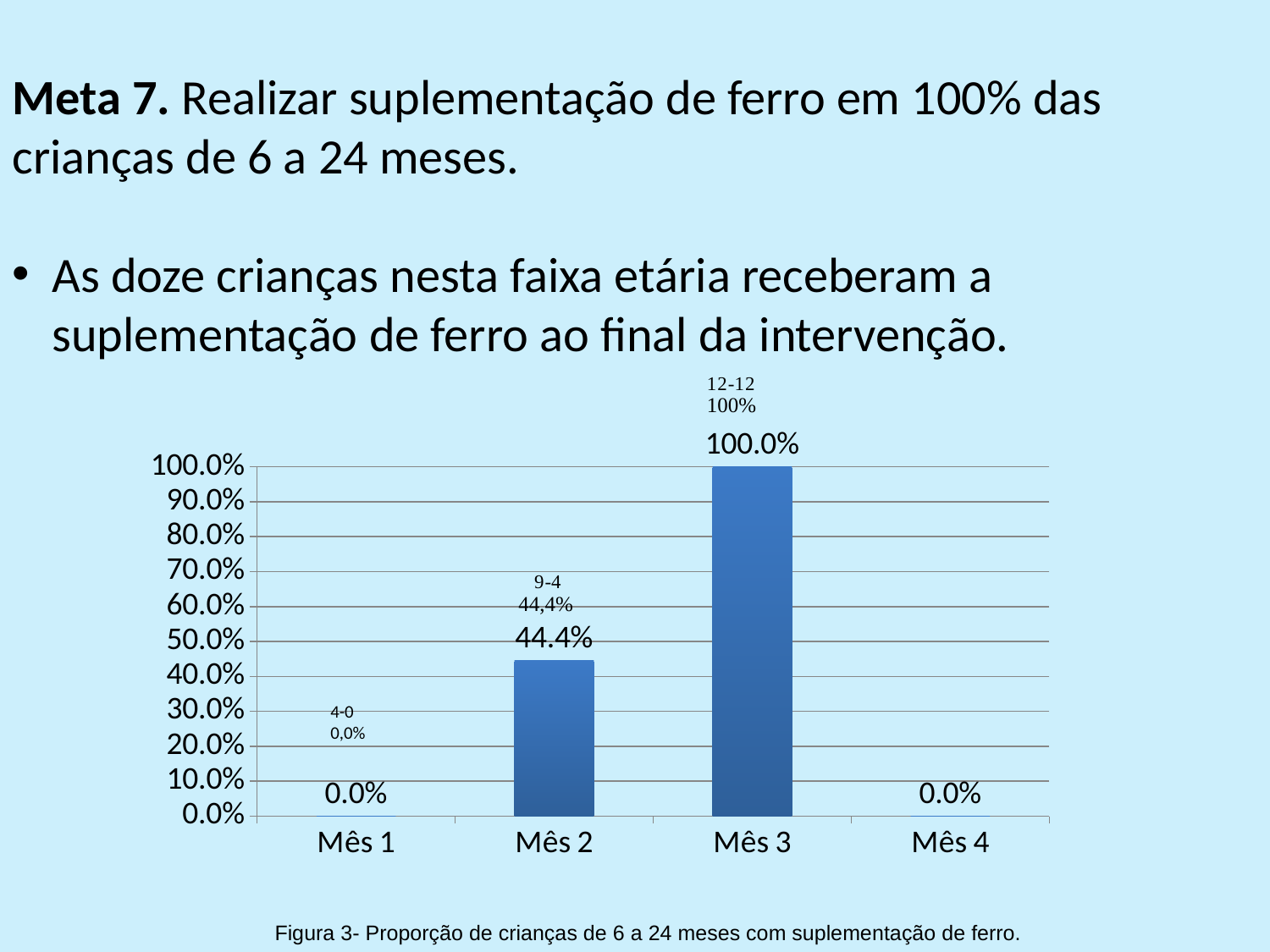
What is the difference between the values for Mês 3 and Mês 2? 55.6% Which month has the highest value? Mês 3 What is the figure caption below the chart? Figura 3- Proporção de crianças de 6 a 24 meses com suplementação de ferro. How many categories are shown on the x axis? 4 What is the value for Mês 2? 44.4% Which is larger, the value for Mês 2 or the value for Mês 3? Mês 3 What is the value for Mês 3? 100.0% Do the values rise or fall from Mês 1 to Mês 3? rise What is the value for Mês 4? 0.0% What kind of chart is shown on the slide? bar chart Is the value for Mês 2 greater or less than 50.0%? less What is the value for Mês 1? 0.0%